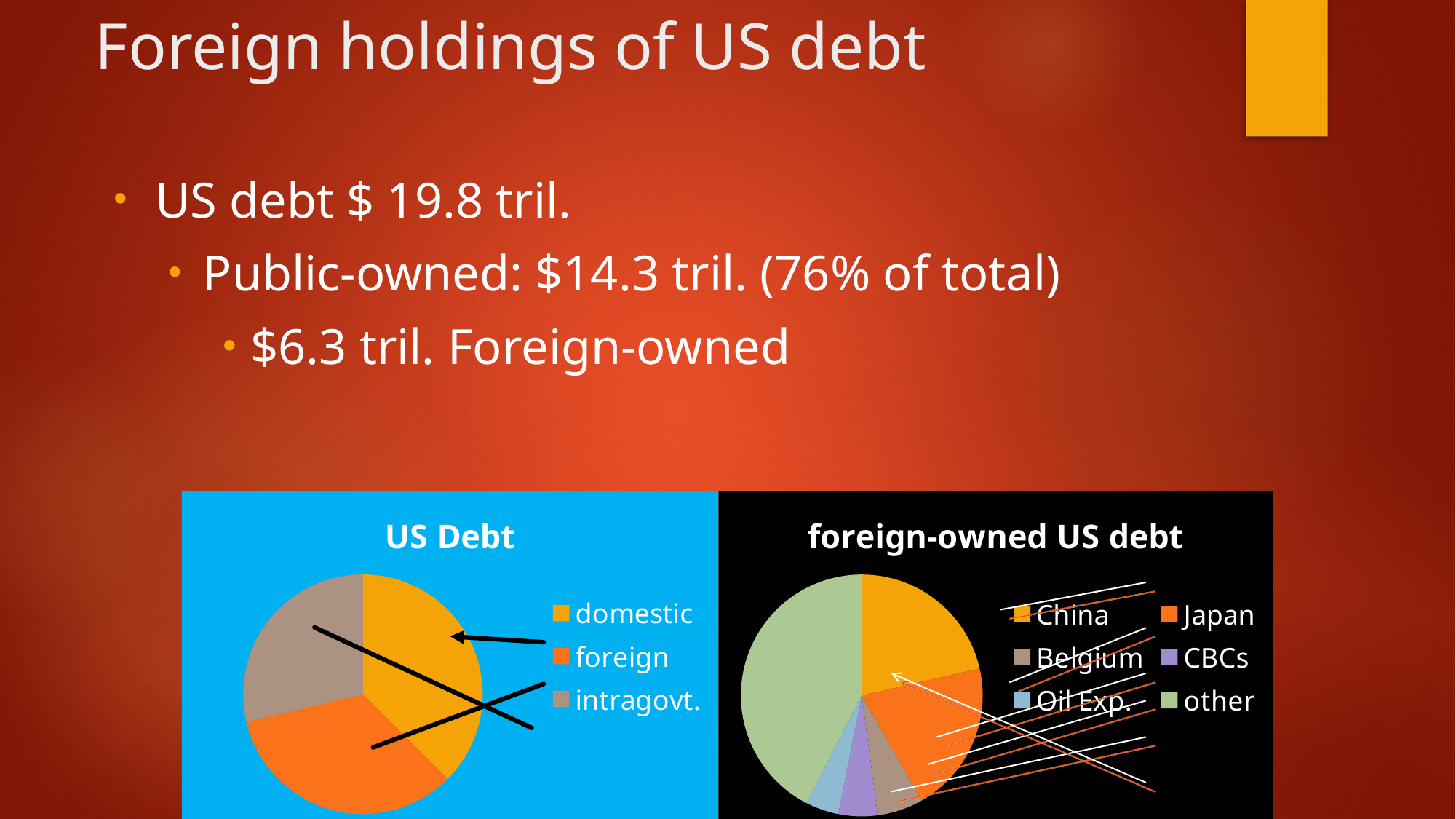
In the 'US Debt' chart, which slice is larger, domestic or intragovt.? domestic In the 'US Debt' chart, how many slices does the pie have? 3 What kind of chart is the 'US Debt' chart on the left? pie chart In the 'foreign-owned US debt' chart, how many categories does the legend list? 6 What kind of chart is the 'foreign-owned US debt' chart on the right? pie chart In the 'foreign-owned US debt' chart, which category has the smallest slice? Oil Exp. In the 'US Debt' chart, what colour is the 'foreign' slice? orange In the 'foreign-owned US debt' chart, which slice is larger, China or Belgium? China In the 'US Debt' chart, which category has the largest slice? domestic In the 'foreign-owned US debt' chart, which category has the largest slice? other What is the title of the chart on the right side of the slide? foreign-owned US debt In the 'foreign-owned US debt' chart, which slice is larger, other or Japan? other